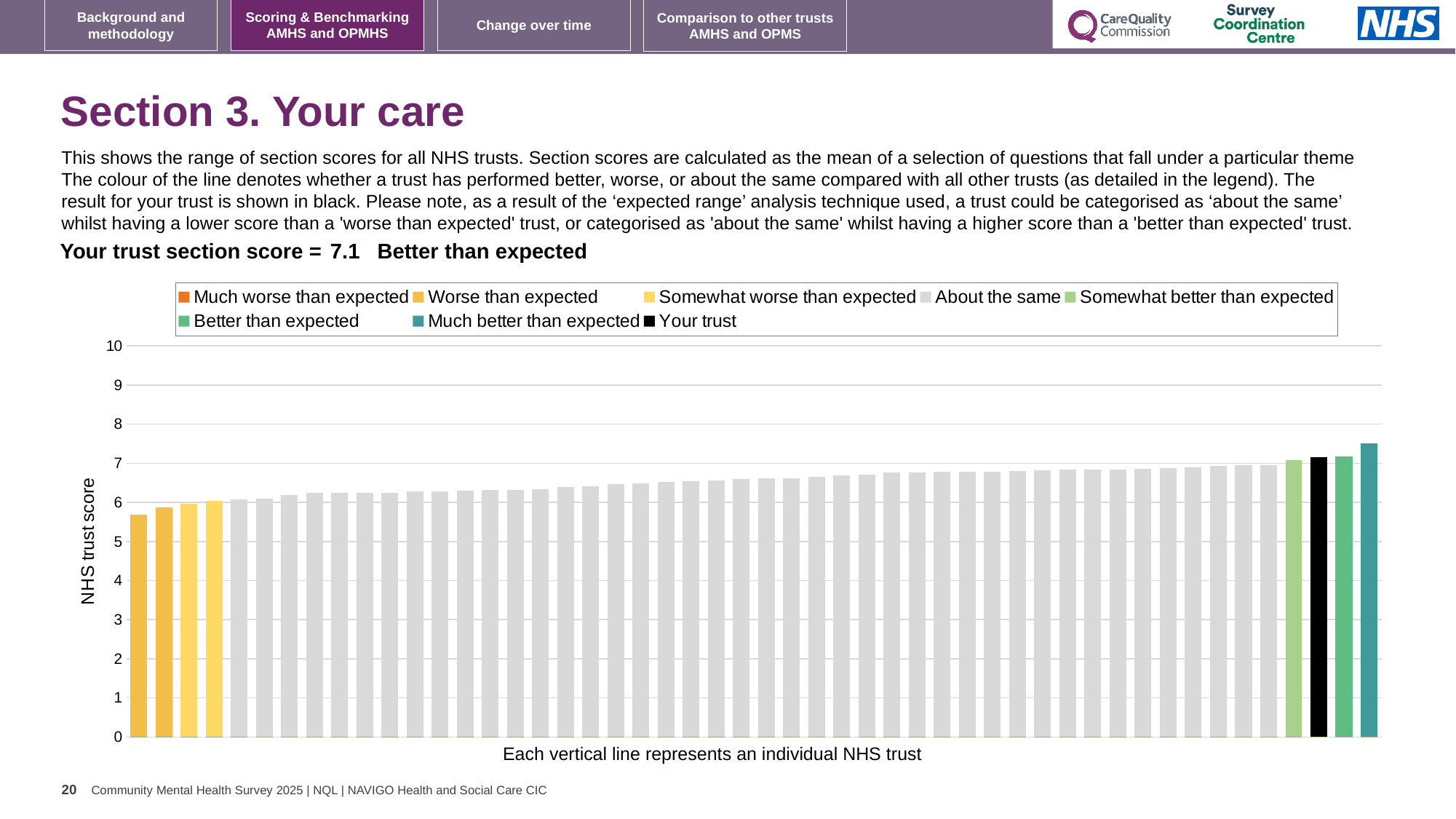
How many entries does the chart legend list? 8 Which legend category does the shortest bar belong to? Worse than expected Which legend category does the tallest bar belong to? Much better than expected What is the section score for your trust (the black bar)? 7.1 Is the value of the shortest bar in the chart greater or less than 6? less Is the value of the tallest bar in the chart greater or less than 7? greater What kind of chart is shown on the slide? bar chart Is the value for your trust (the black bar) greater or less than 8? less How many bars are coloured as 'Somewhat worse than expected'? 2 Do the bar values rise or fall from left to right along the x axis? rise What is the label on the vertical axis of the chart? NHS trust score What does the caption below the x axis say each vertical line represents? an individual NHS trust